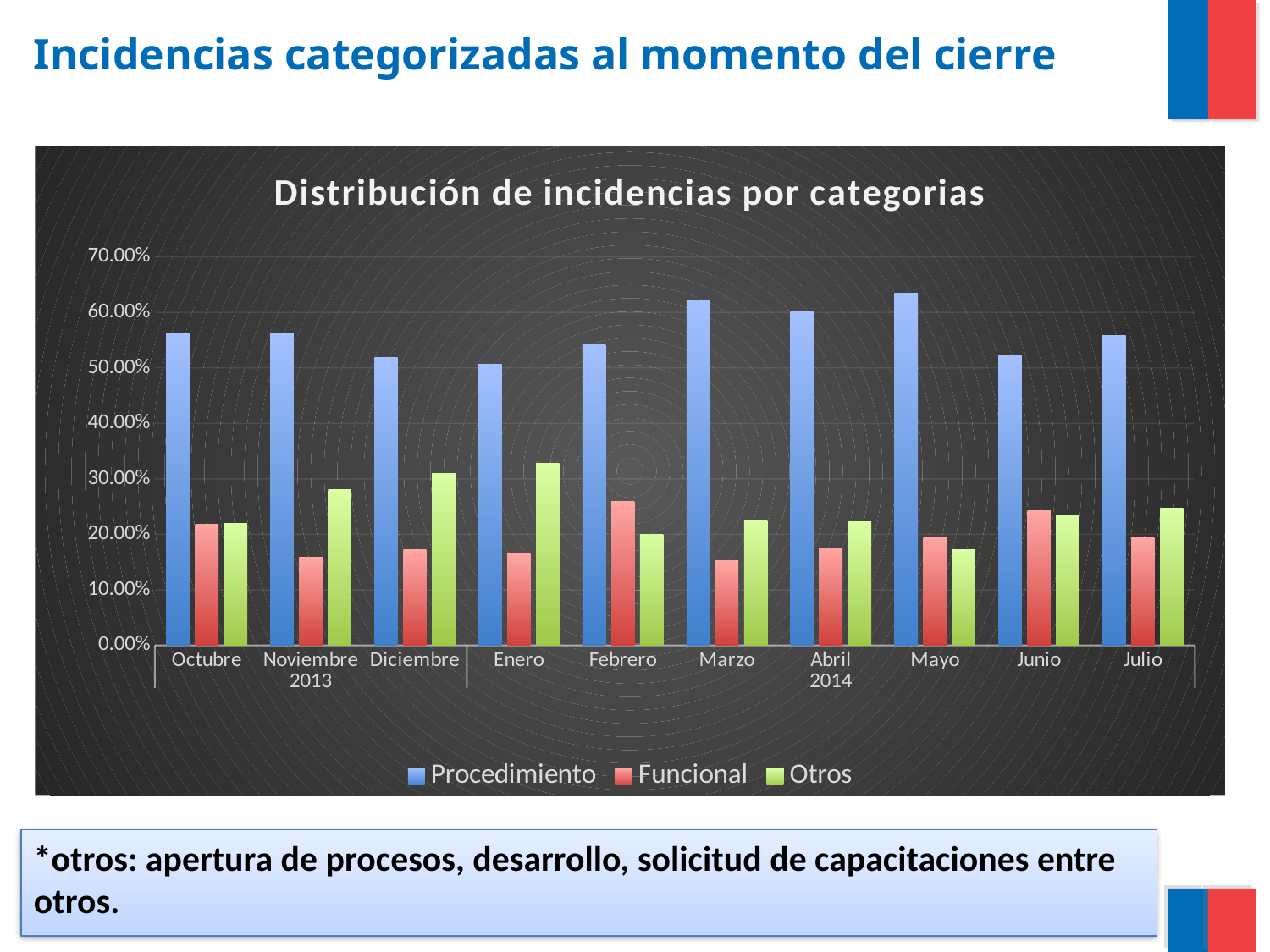
Is the Otros value for Enero greater or less than 30.00%? greater How many months are shown on the x axis? 10 Is the Funcional value for Febrero greater or less than 20.00%? greater Is the Procedimiento value for Marzo greater or less than 60.00%? greater Which series is shown in green in the legend? Otros In Febrero, which is larger: Funcional or Otros? Funcional What is the title of the chart? Distribución de incidencias por categorias In Diciembre, which is larger: Funcional or Otros? Otros Which month has the lowest Otros value? Mayo What kind of chart is shown on the slide? Bar chart How many series does the legend list? 3